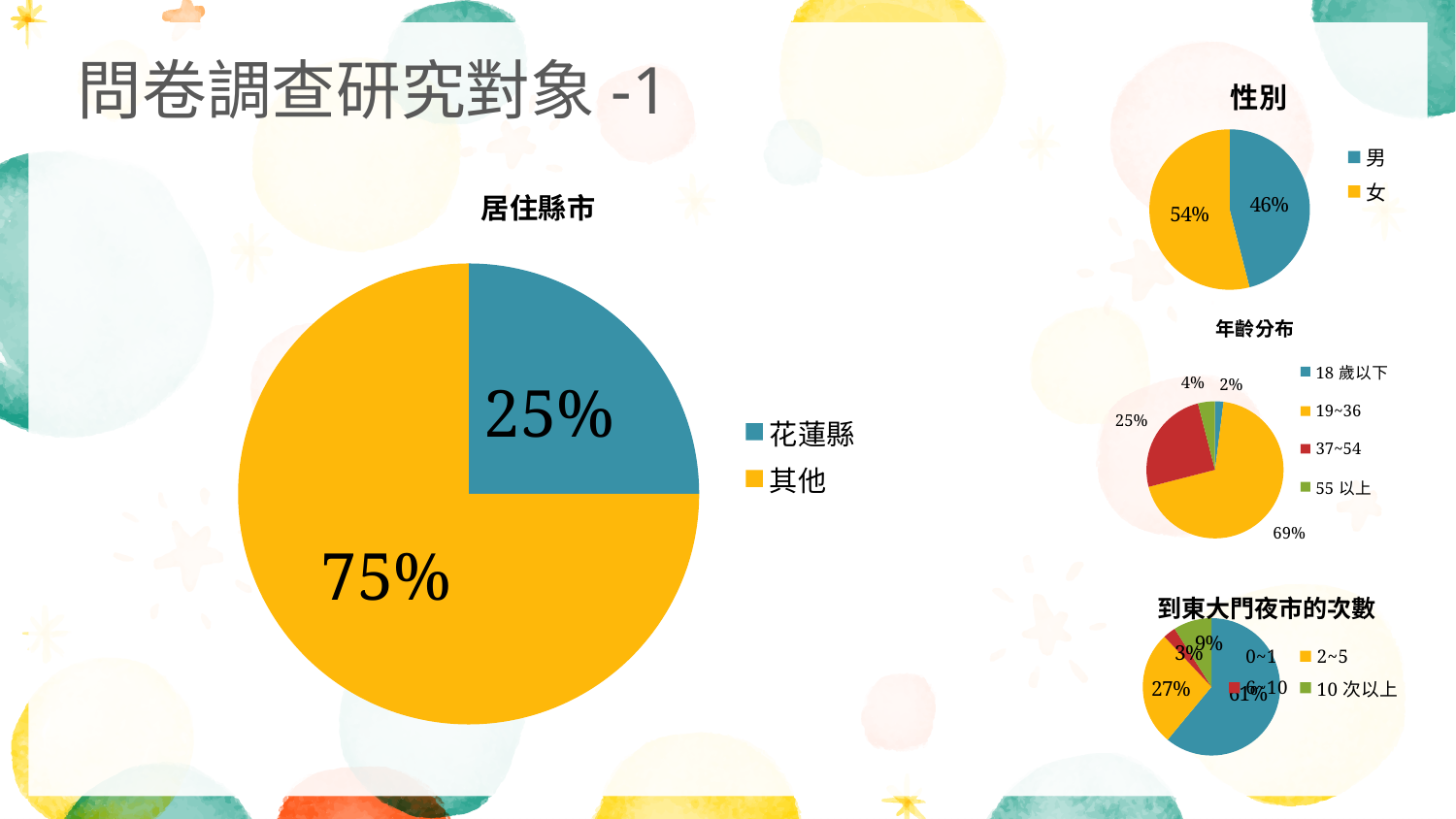
In the 性別 chart, which category has the larger share, 男 or 女? 女 In the 年齡分布 chart, which age group has the smallest share? 18 歲以下 In the 居住縣市 chart, what percentage is shown for 花蓮縣? 25% In the 性別 chart, what percentage is shown for 女? 54% In the 年齡分布 chart, what percentage is shown for 19~36? 69% What kind of chart is the 居住縣市 chart? pie chart In the 性別 chart, what percentage is shown for 男? 46% In the 到東大門夜市的次數 chart, what percentage is shown for 2~5? 27% How many categories does the legend of the 年齡分布 chart list? 4 In the 居住縣市 chart, what is the difference between the 其他 share and the 花蓮縣 share? 50% In the 年齡分布 chart, what is the difference between the 37~54 share and the 55 以上 share? 21% In the 居住縣市 chart, what percentage is shown for 其他? 75%